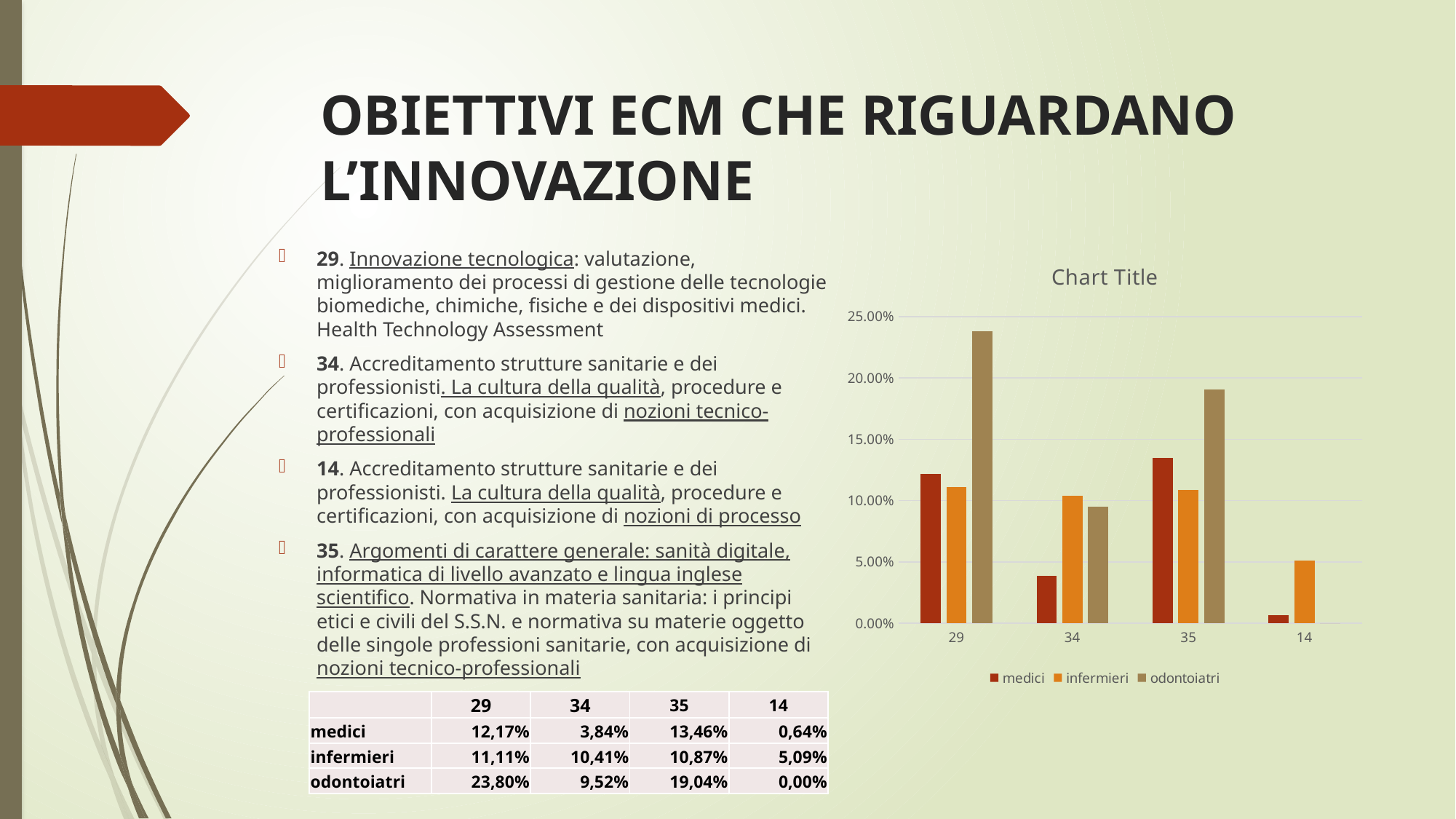
For which category is the odontoiatri value highest? 29 What is the medici value for category 35? 13,46% How many series does the chart legend list? 3 What kind of chart is shown on the slide? bar chart For which category is the medici value lowest? 14 For category 34, which is larger: medici or infermieri? infermieri How many categories are shown on the x axis of the chart? 4 Is the odontoiatri value for category 29 greater or less than 20.00%? greater What is the infermieri value for category 14? 5,09% What is the difference between the odontoiatri values for categories 29 and 35? 4,76% Is the medici value for category 34 greater or less than 5.00%? less What is the title of the chart? Chart Title